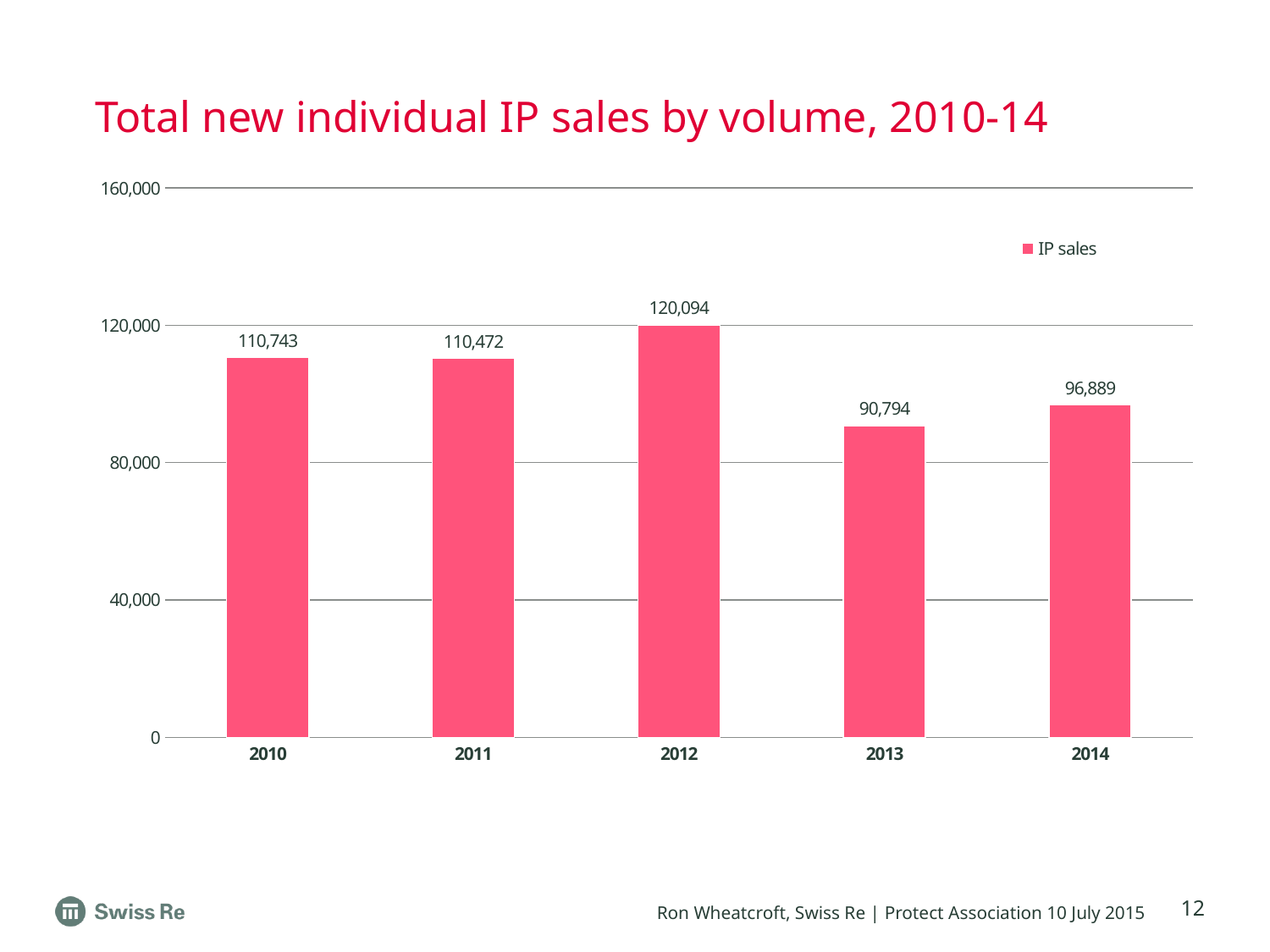
What kind of chart is shown on the slide? Bar chart How many years are shown on the chart? 5 Which year has the lowest IP sales? 2013 What is the difference in IP sales between 2014 and 2013? 6,095 What is the value of IP sales for 2012? 120,094 What is the value of IP sales for 2010? 110,743 Which year has higher IP sales, 2011 or 2014? 2011 What is the difference in IP sales between 2012 and 2013? 29,300 Which year has the highest IP sales? 2012 Is the value for 2014 greater or less than 80,000? greater What is the value of IP sales for 2013? 90,794 What is the title of the chart? Total new individual IP sales by volume, 2010-14